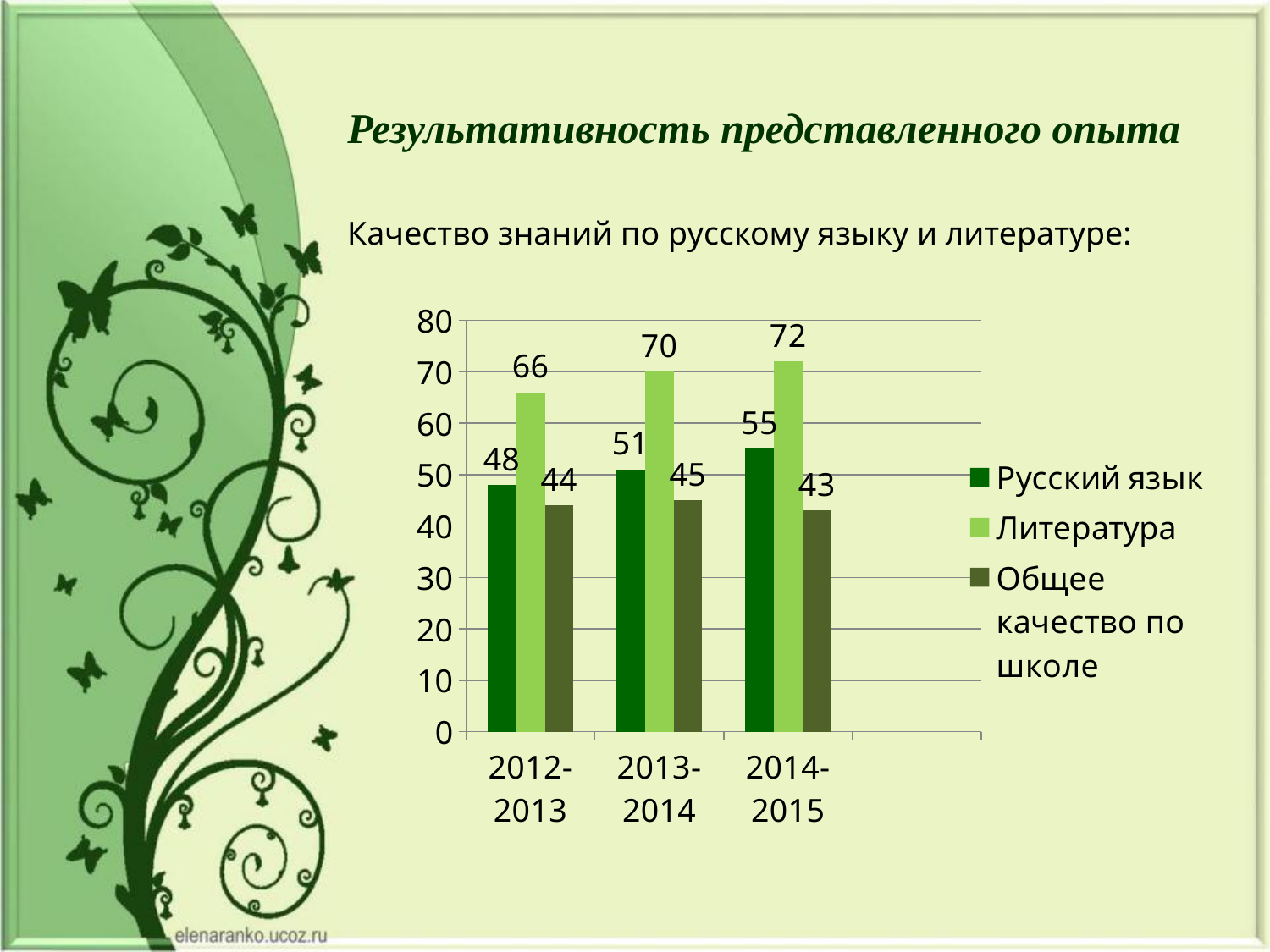
What kind of chart is shown on the slide? bar chart What is the value for Общее качество по школе in 2014-2015? 43 What is the value for Русский язык in 2012-2013? 48 What is the difference between Литература and Русский язык in 2014-2015? 17 How many series does the legend list? 3 What is the text above the chart describing what it shows? Качество знаний по русскому языку и литературе: What is the value for Литература in 2013-2014? 70 Which is larger in 2013-2014: Русский язык or Общее качество по школе? Русский язык Do the values for Русский язык rise or fall from 2012-2013 to 2014-2015? rise How many year categories are shown on the x axis? 3 In which year is the value for Общее качество по школе lowest? 2014-2015 In which year is the value for Литература highest? 2014-2015